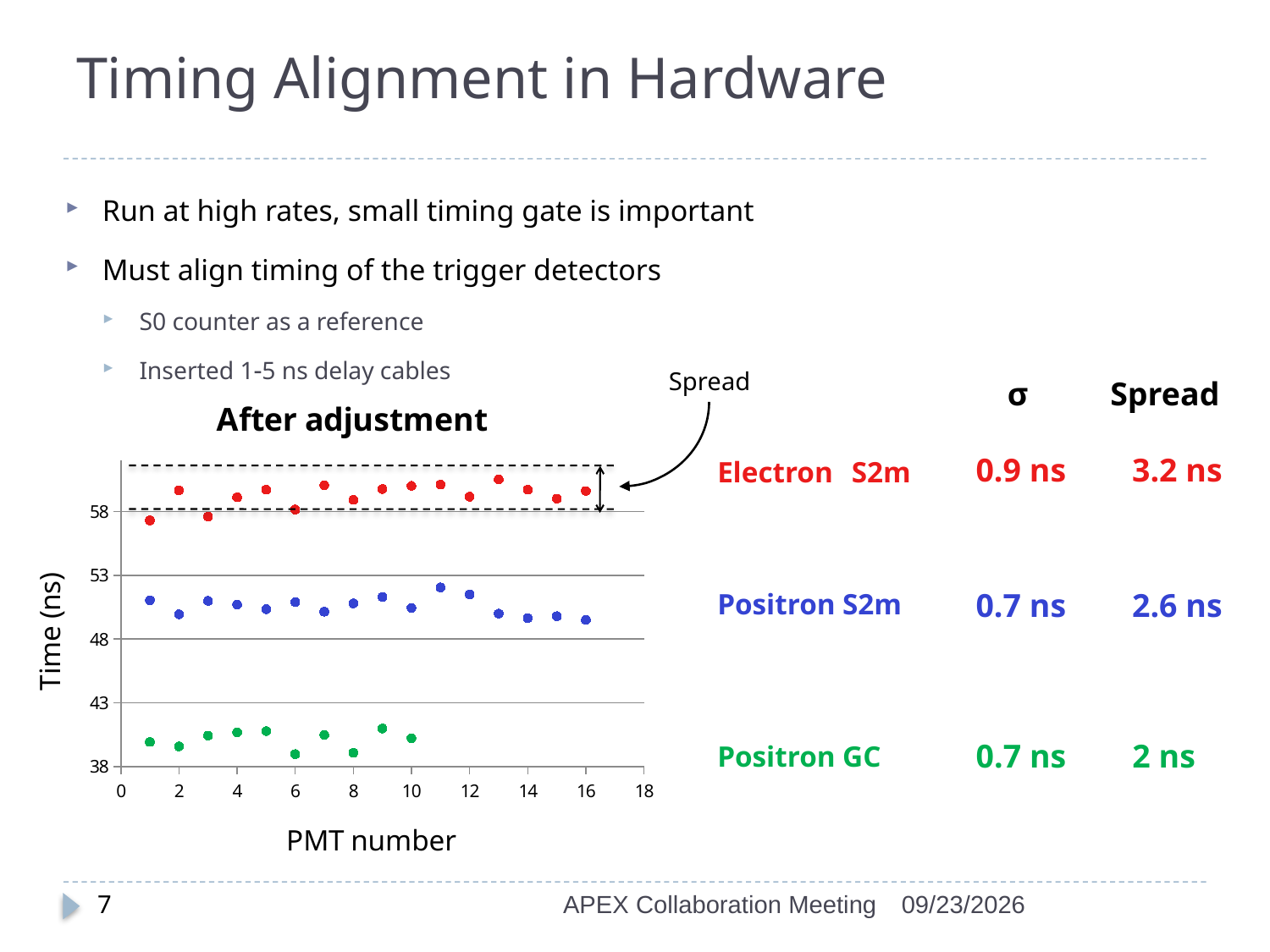
How many points are plotted for the Electron S2m series? 16 Is the Electron S2m value at PMT number 7 greater or less than 58? greater Which PMT number has the highest Positron S2m time? 11 Which PMT number has the lowest Positron GC time? 6 How many points are plotted for the Positron GC series? 10 At PMT number 5, which series has the larger time, Electron S2m or Positron S2m? Electron S2m What is the label of the y axis of the chart? Time (ns) Is the Positron GC value at PMT number 9 greater or less than 43? less What kind of chart is shown on the slide? scatter chart Is the Positron S2m value at PMT number 11 greater or less than 48? greater How many series are plotted in the chart? 3 What is the title of the chart? After adjustment